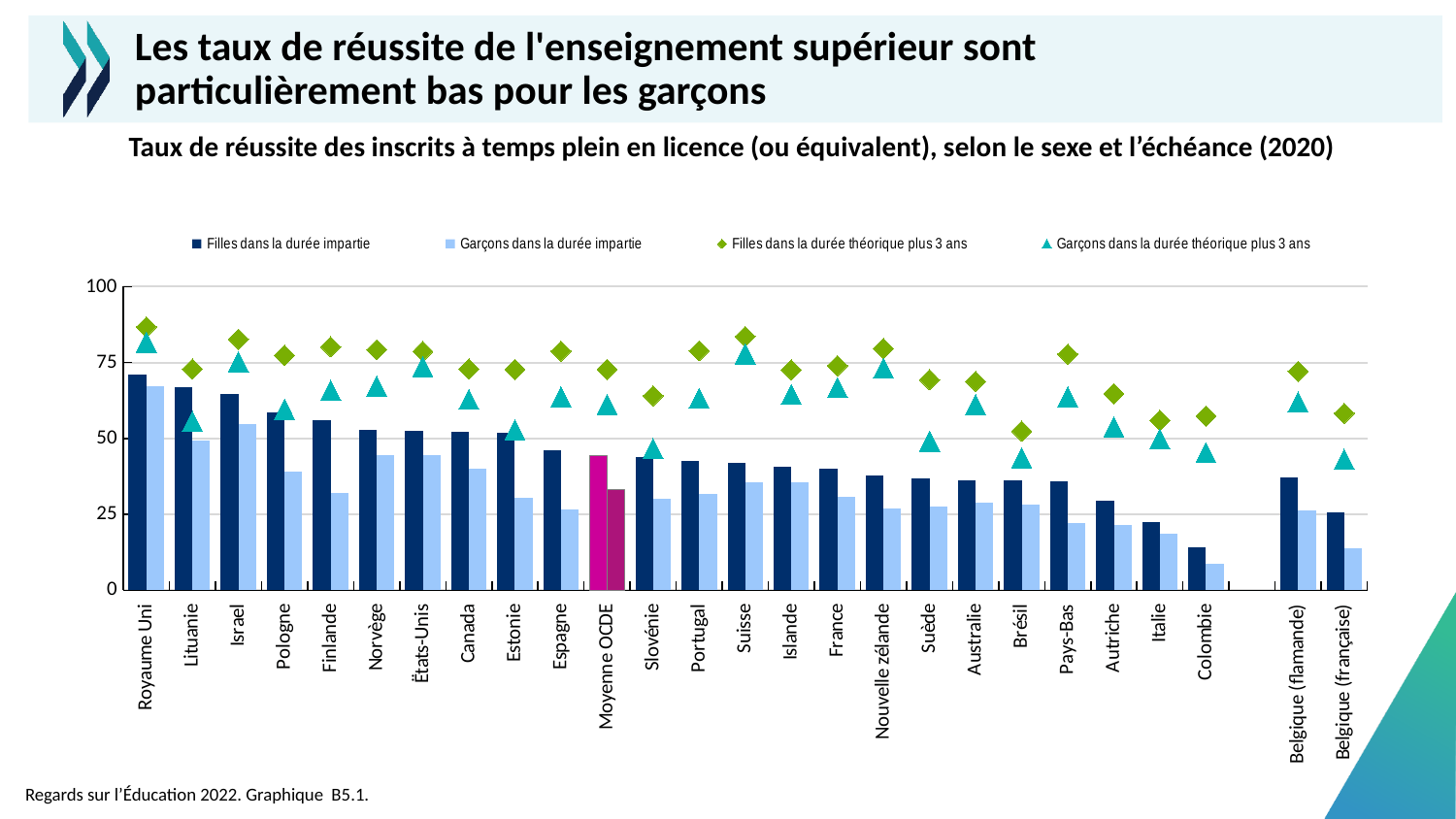
Which category has the highest value for 'Filles dans la durée impartie'? Royaume Uni Is the value for 'Filles dans la durée impartie' for Moyenne OCDE greater or less than 50? less Is the value for 'Filles dans la durée théorique plus 3 ans' in Royaume Uni greater or less than 75? greater In Pologne, which is larger: 'Filles dans la durée impartie' or 'Garçons dans la durée impartie'? Filles dans la durée impartie Is the value for 'Filles dans la durée impartie' in Colombie greater or less than 25? less How many countries or categories are shown along the x axis? 26 What kind of chart is shown on the slide? bar chart How many series does the legend list? 4 Which category's bars are highlighted in a different colour (magenta) from the others? Moyenne OCDE Do the values for 'Filles dans la durée impartie' generally rise or fall from Royaume Uni to Colombie along the x axis? fall Which category has the lowest value for 'Garçons dans la durée impartie'? Colombie